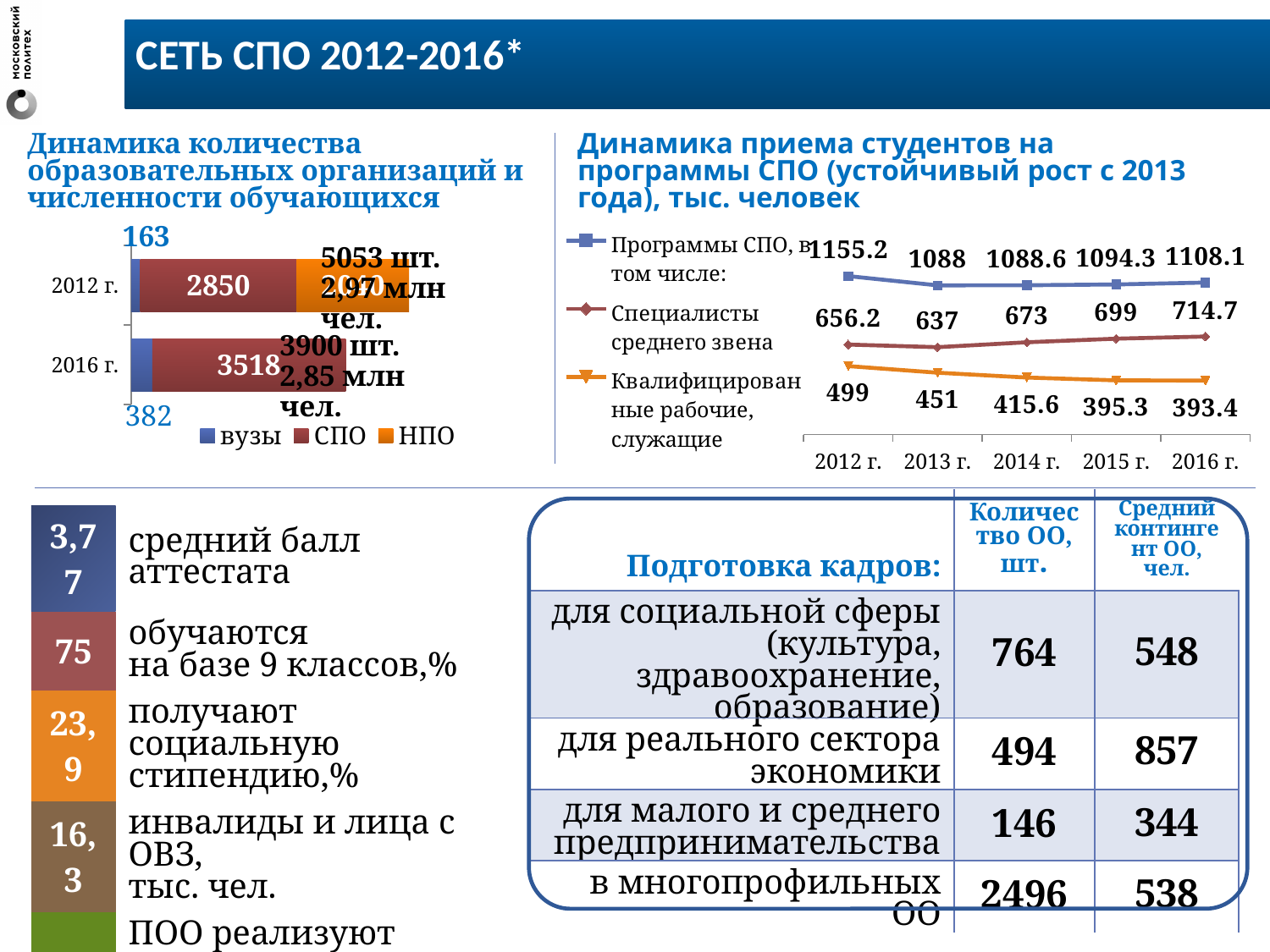
On the right-hand line chart, what is the value for Специалисты среднего звена in 2016 г.? 714.7 What kind of chart is the left-hand chart showing вузы, СПО and НПО? bar chart On the left-hand bar chart, what is the value for СПО in 2016 г.? 3518 On the right-hand line chart, in which year is the value for Квалифицированные рабочие, служащие lowest? 2016 г. How many series does the legend of the right-hand line chart list? 3 On the left-hand bar chart, which is larger: the СПО value for 2012 г. or for 2016 г.? 2016 г. On the right-hand line chart, what is the difference between the Специалисты среднего звена values for 2016 г. and 2012 г.? 58.5 On the right-hand line chart, in which year is the value for Программы СПО highest? 2012 г. On the right-hand line chart, does the Квалифицированные рабочие, служащие series rise or fall from 2012 г. to 2016 г.? fall On the left-hand bar chart, what is the value for вузы in 2012 г.? 163 On the right-hand line chart, what is the value for Квалифицированные рабочие, служащие in 2014 г.? 415.6 On the right-hand line chart, what is the value for Программы СПО in 2012 г.? 1155.2